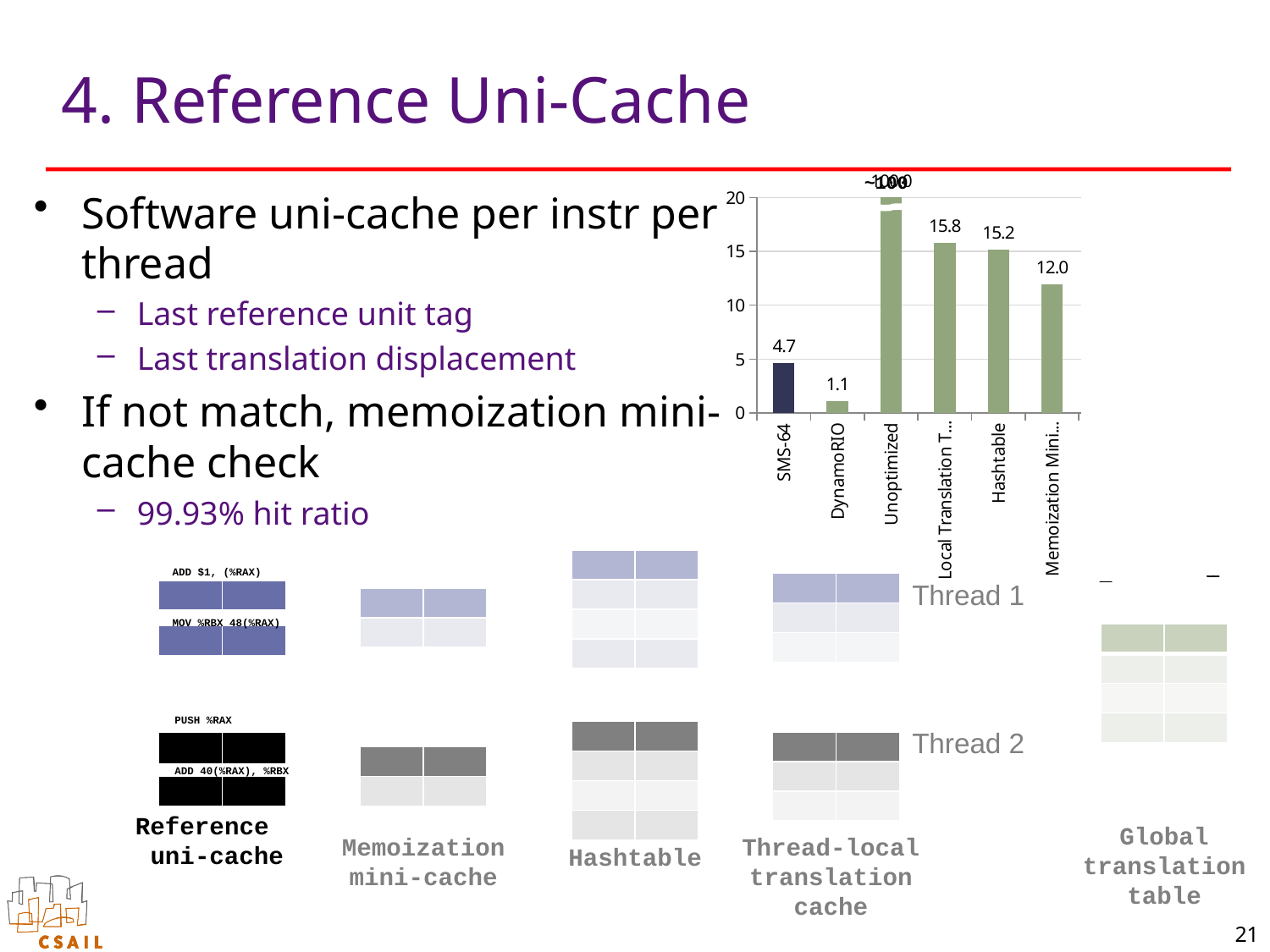
What is the value for Hashtable in the bar chart? 15.2 How many categories are shown on the x axis of the bar chart? 6 Is the value for Hashtable in the bar chart greater or less than 10? greater What is the value for DynamoRIO in the bar chart? 1.1 What is the difference between the Hashtable value and the SMS-64 value in the bar chart? 10.5 Which category has the highest value in the bar chart? Unoptimized What is the difference between the SMS-64 value and the DynamoRIO value in the bar chart? 3.6 Which is larger in the bar chart, the value for SMS-64 or the value for DynamoRIO? SMS-64 What kind of chart is shown on the slide? bar chart Which category has the lowest value in the bar chart? DynamoRIO What is the value for SMS-64 in the bar chart? 4.7 Is the value for SMS-64 in the bar chart greater or less than 5? less